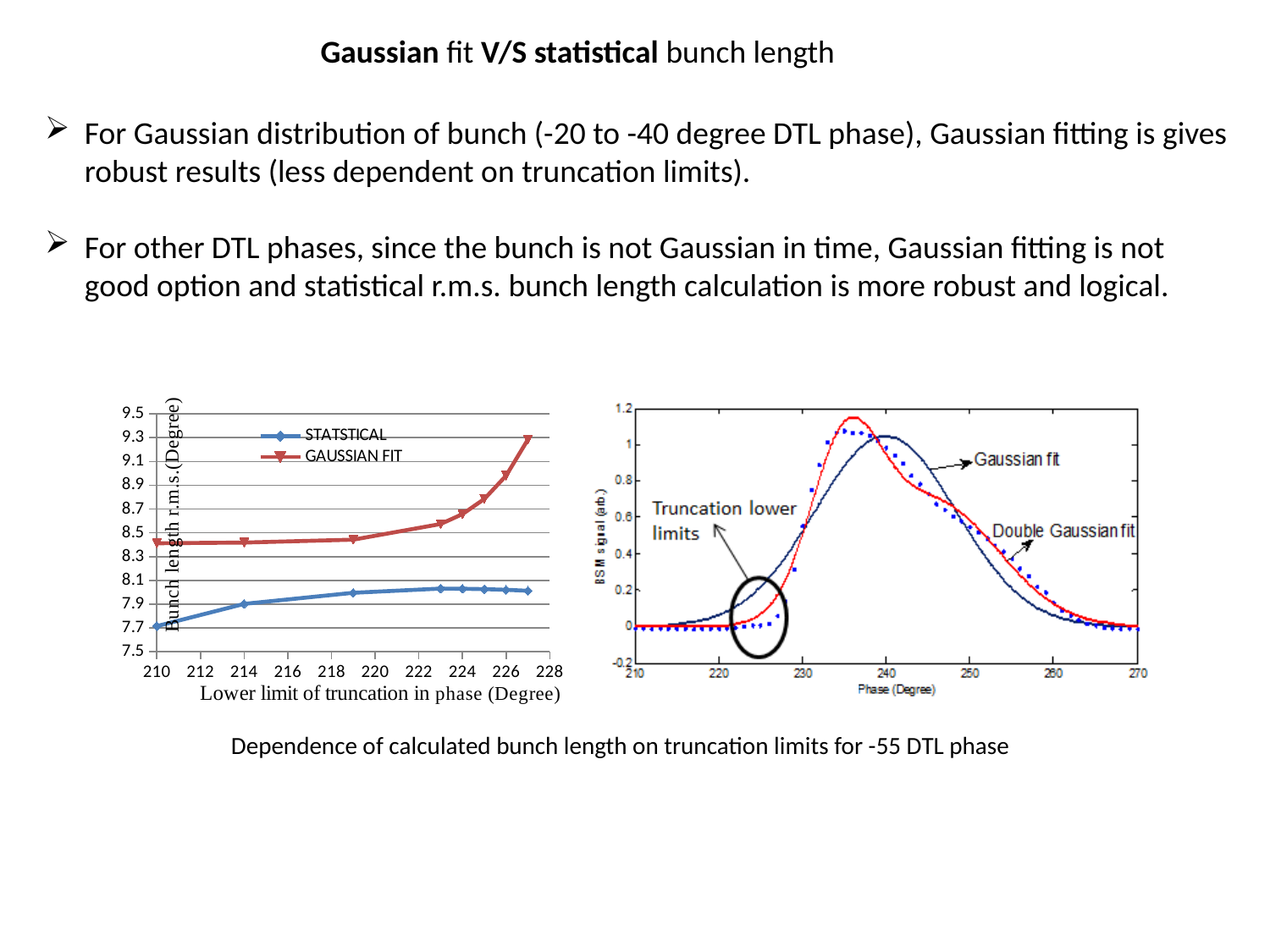
On the left chart, which series has the higher bunch length at a lower limit of truncation of 227 degrees? GAUSSIAN FIT On the left chart, is the STATSTICAL value at a lower limit of 224 degrees greater or less than 8.3? less On the left chart, how many series does the legend list? 2 On the right chart, is the peak of the Double Gaussian fit curve greater or less than 1? greater On the left chart, what kind of chart is it? line chart On the left chart, is the GAUSSIAN FIT value at a lower limit of 227 degrees greater or less than 9.1? greater On the left chart, what is the label of the x axis? Lower limit of truncation in phase (Degree) On the right chart, which curve reaches the higher peak, the Gaussian fit or the Double Gaussian fit? Double Gaussian fit On the left chart, what are the two series named in the legend? STATSTICAL and GAUSSIAN FIT On the left chart, does the GAUSSIAN FIT bunch length rise or fall as the lower limit of truncation increases from 219 to 227 degrees? rise